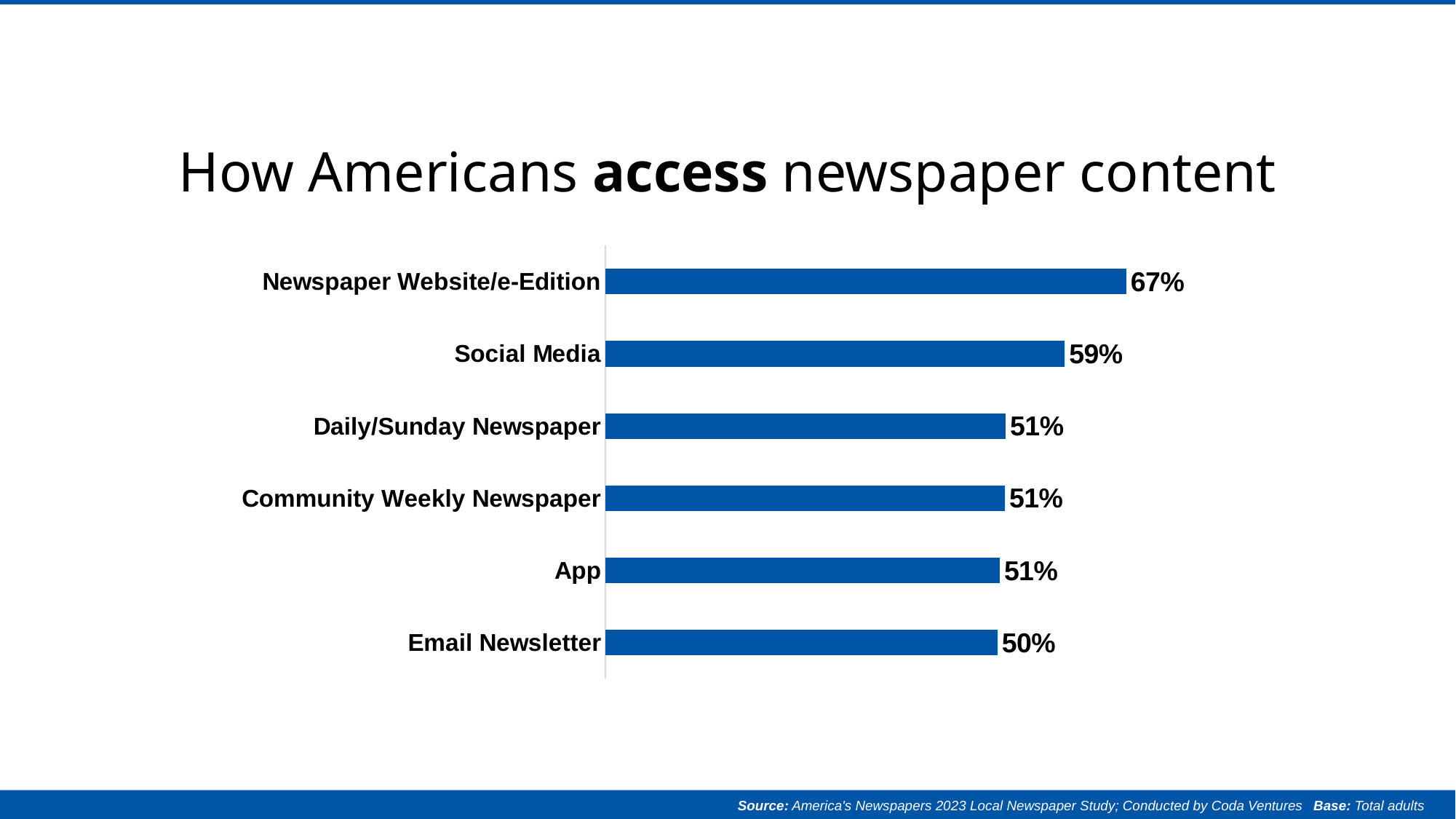
What is the value for Email Newsletter? 50% What kind of chart is shown on the slide? Bar chart Which access method has the highest value? Newspaper Website/e-Edition What is the difference between the values for Newspaper Website/e-Edition and Social Media? 8% What is the value for App? 51% What is the title of the slide? How Americans access newspaper content How many access methods are shown in the chart? 6 What is the difference between the values for Social Media and Daily/Sunday Newspaper? 8% Which access method has the lowest value? Email Newsletter Which is larger, the value for Social Media or the value for Community Weekly Newspaper? Social Media What percentage of Americans access newspaper content via Newspaper Website/e-Edition? 67% What is the value for Social Media? 59%